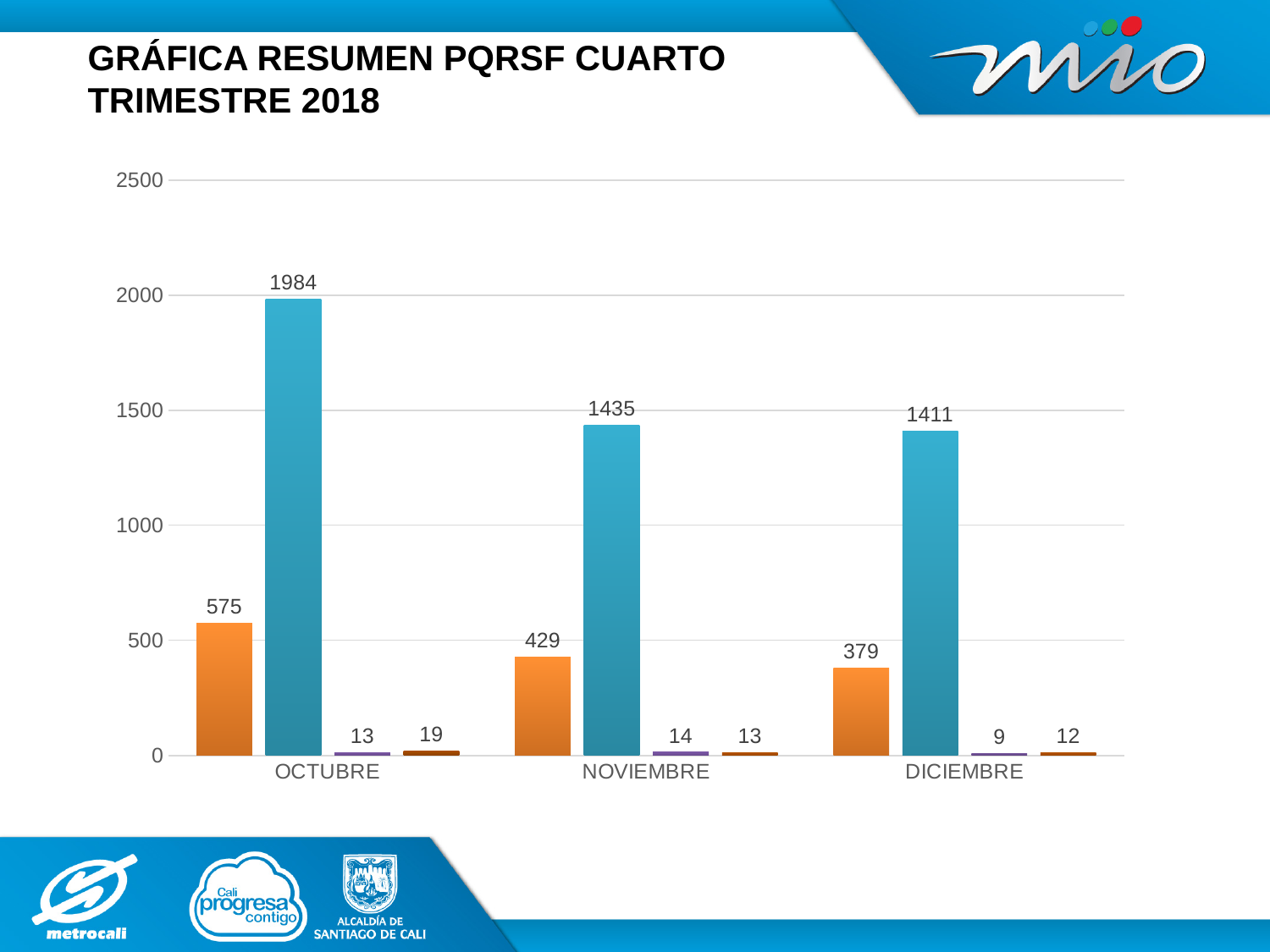
Which month has the highest teal bar? OCTUBRE Is the value of the orange bar for OCTUBRE greater or less than 500? greater What is the value of the orange bar for NOVIEMBRE? 429 What is the value of the orange bar for DICIEMBRE? 379 How many months are shown on the x axis? 3 What kind of chart is shown on the slide? bar chart What is the value of the tallest (teal) bar for OCTUBRE? 1984 What is the value of the teal bar for NOVIEMBRE? 1435 What is the difference between the teal bar values for OCTUBRE and NOVIEMBRE? 549 Which is larger, the teal bar for NOVIEMBRE or the teal bar for DICIEMBRE? NOVIEMBRE Do the teal bar values rise or fall from OCTUBRE to DICIEMBRE? fall Which month has the lowest orange bar? DICIEMBRE